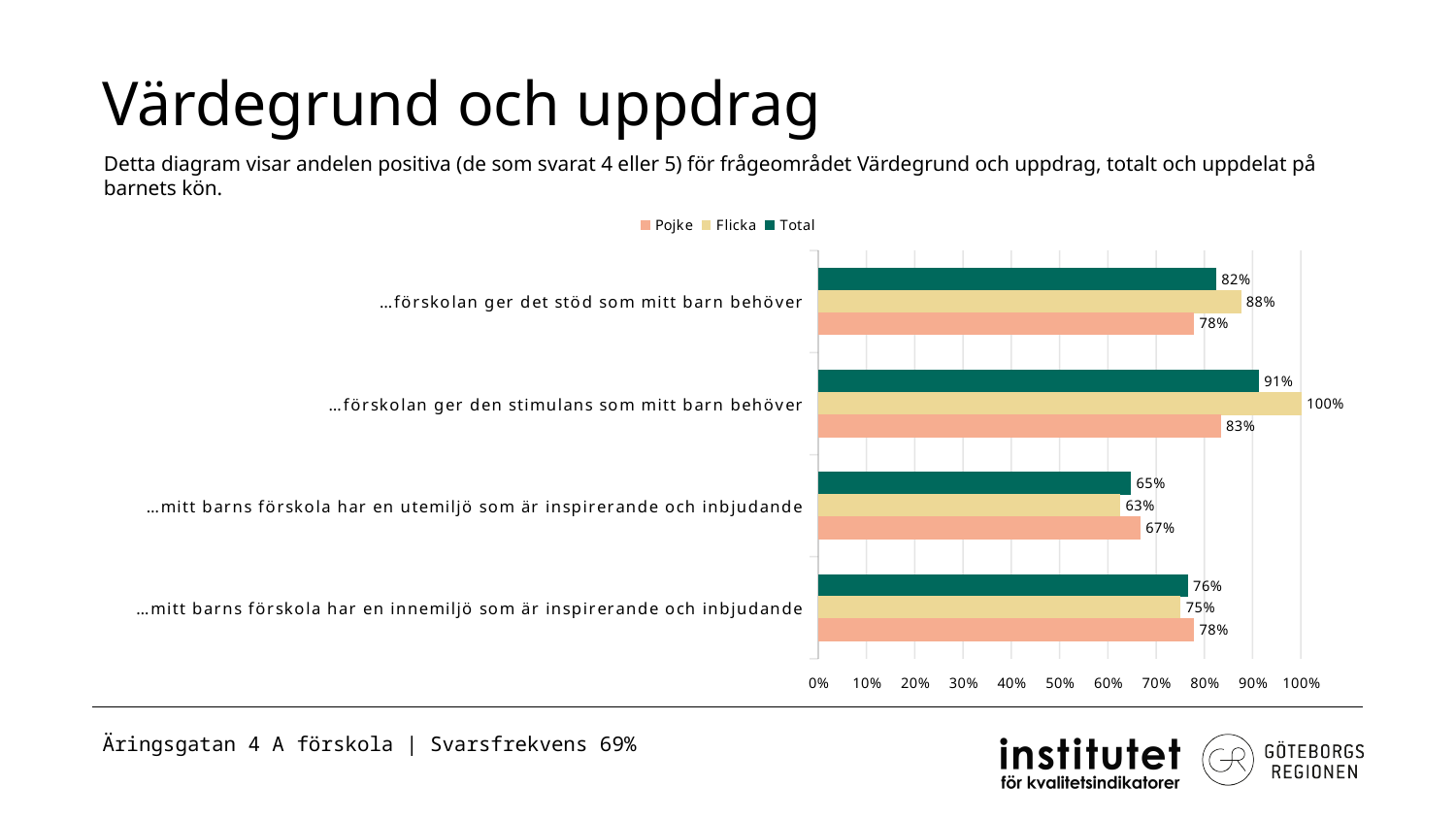
How many series does the legend list? 3 What is the Flicka value for "…förskolan ger den stimulans som mitt barn behöver"? 100% What kind of chart is shown on the slide? Bar chart What is the Total value for "…mitt barns förskola har en utemiljö som är inspirerande och inbjudande"? 65% What is the Pojke value for "…förskolan ger det stöd som mitt barn behöver"? 78% Which category has the highest Total value? …förskolan ger den stimulans som mitt barn behöver Which series is shown in green in the legend? Total What is the Flicka value for "…mitt barns förskola har en innemiljö som är inspirerande och inbjudande"? 75% For "…mitt barns förskola har en utemiljö som är inspirerande och inbjudande", which is larger, the Pojke value or the Flicka value? Pojke What is the difference between the Flicka and Pojke values for "…förskolan ger den stimulans som mitt barn behöver"? 17% Which category has the lowest Flicka value? …mitt barns förskola har en utemiljö som är inspirerande och inbjudande How many categories are shown on the chart? 4